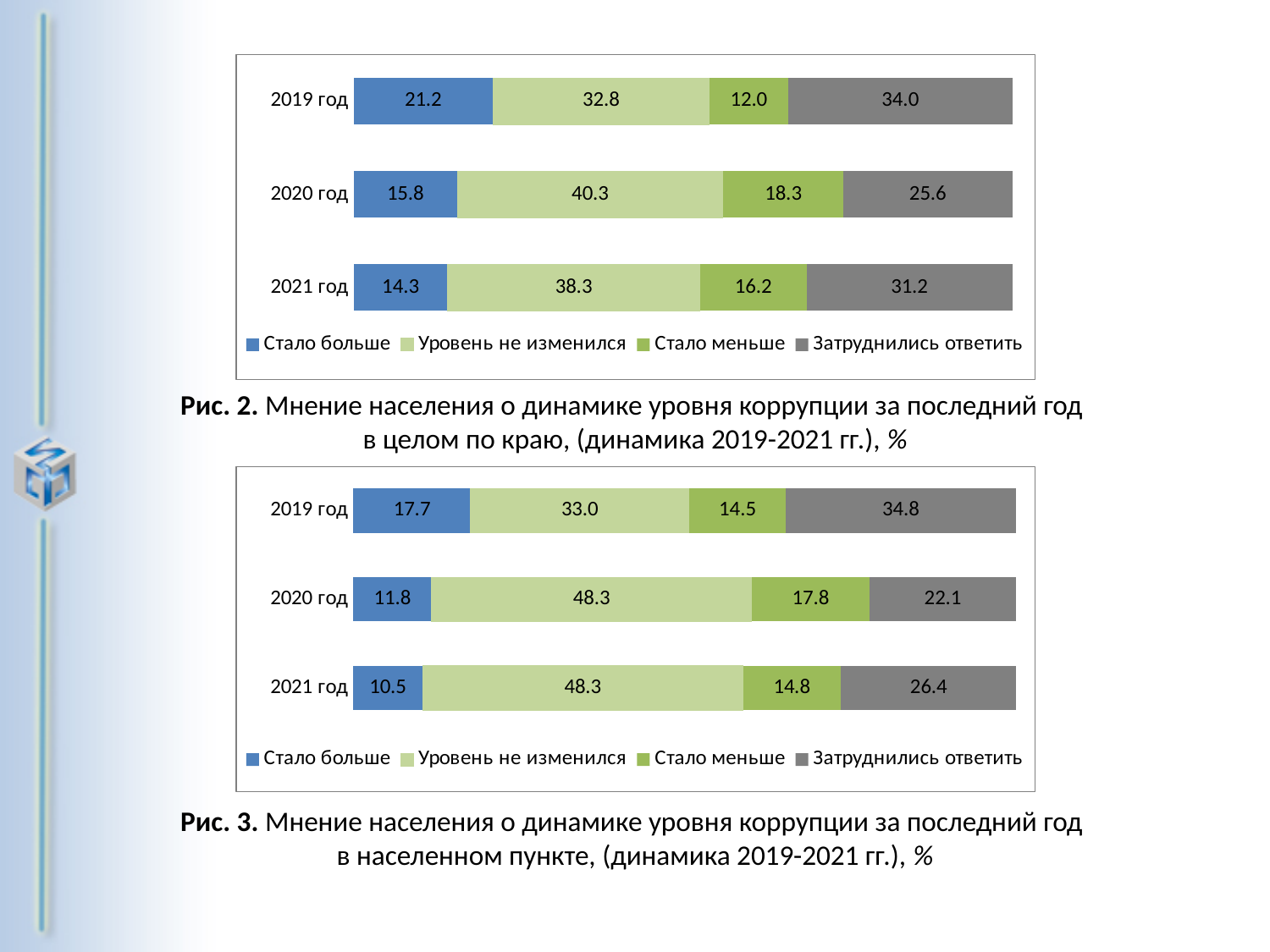
In the top chart (Рис. 2), what is the value for "Стало больше" in 2019 год? 21.2 How many years are shown in the bottom chart (Рис. 3)? 3 In the top chart (Рис. 2), what is the difference between the "Затруднились ответить" values for 2019 год and 2020 год? 8.4 In the top chart (Рис. 2), does the value for "Стало больше" rise or fall from 2019 год to 2021 год? Fall What kind of chart is the bottom chart (Рис. 3)? Stacked bar chart In the bottom chart (Рис. 3), which year has the lowest value for "Стало больше"? 2021 год In the bottom chart (Рис. 3), which is larger: "Уровень не изменился" in 2019 год or in 2020 год? 2020 год In the top chart (Рис. 2), which year has the highest value for "Стало больше"? 2019 год In the bottom chart (Рис. 3), what is the value for "Стало меньше" in 2020 год? 17.8 In the top chart (Рис. 2), what is the value for "Уровень не изменился" in 2020 год? 40.3 How many series does the legend of the top chart (Рис. 2) list? 4 In the bottom chart (Рис. 3), what is the value for "Затруднились ответить" in 2021 год? 26.4